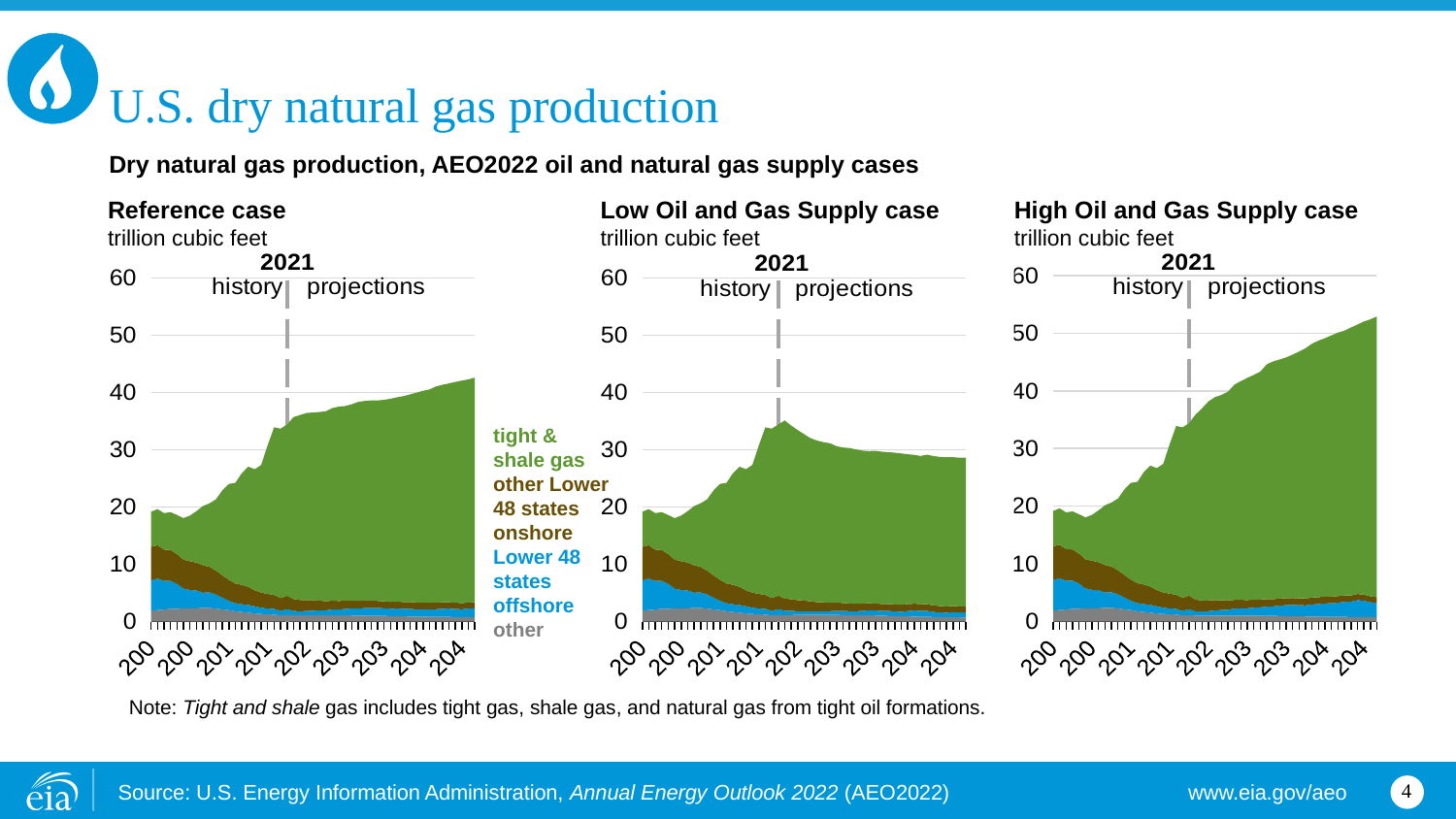
In the Low Oil and Gas Supply case chart, is total dry natural gas production in 2050 greater or less than 30 trillion cubic feet? less In the Reference case chart, is total dry natural gas production in 2050 greater or less than 40 trillion cubic feet? greater How many charts are shown on the slide? 3 In the High Oil and Gas Supply case chart, does total production rise or fall over the projection period after 2021? rise What unit is used on the y axis of the three charts? trillion cubic feet In the High Oil and Gas Supply case chart, is total dry natural gas production in 2050 greater or less than 50 trillion cubic feet? greater What kind of chart is used for the Reference case? stacked area chart How many series does the legend list for the charts? 4 Which series accounts for the largest share of production in the Reference case chart? tight & shale gas Which of the three cases shows the highest total dry natural gas production in 2050? High Oil and Gas Supply case In the Low Oil and Gas Supply case chart, does total production rise or fall over the projection period after 2021? fall